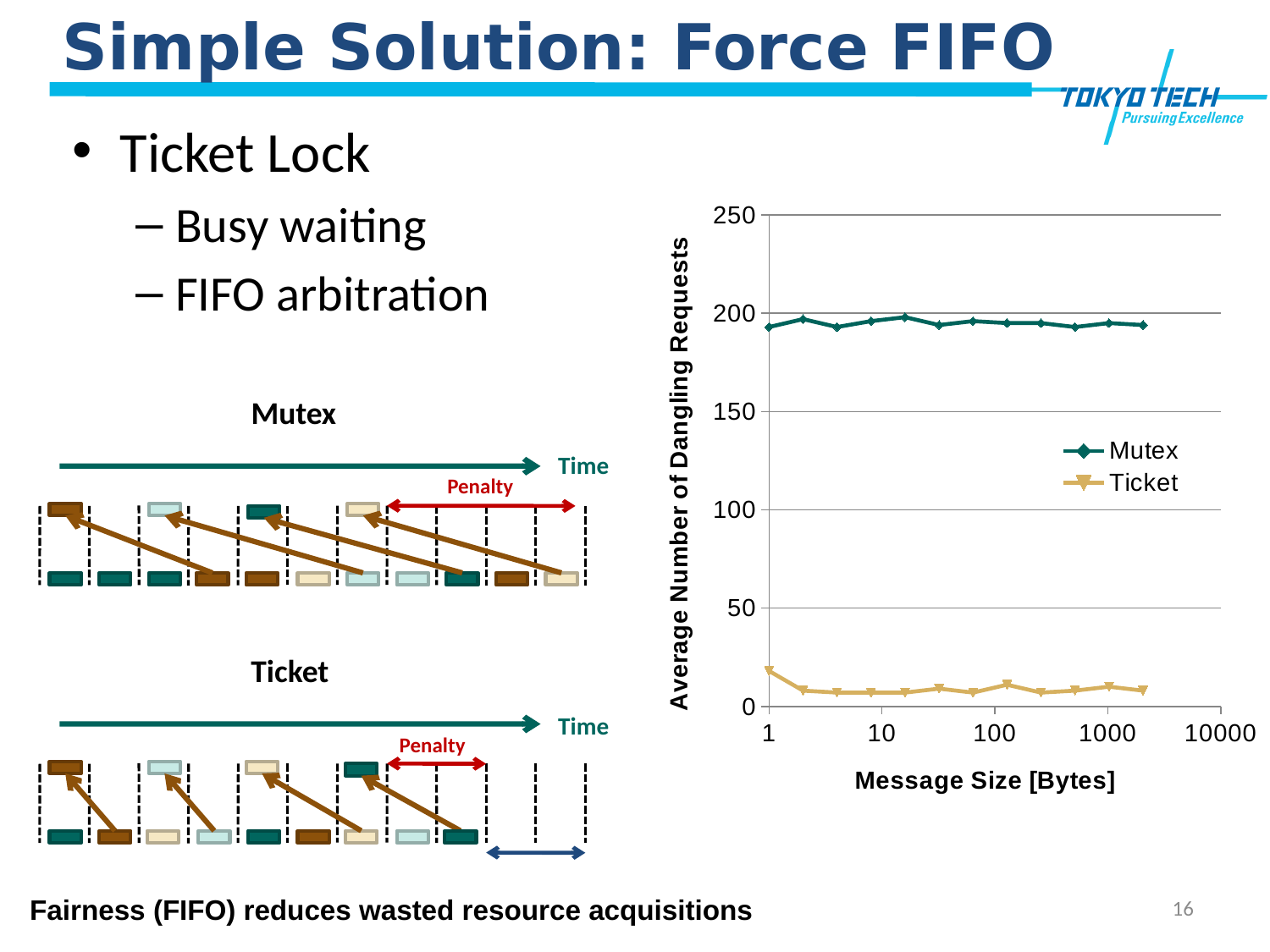
Does the Mutex series stay roughly flat, rise steadily, or fall steadily as message size increases? roughly flat What are the two series named in the chart legend? Mutex and Ticket Is the Ticket value at a message size of 1 byte greater or less than 50? less What kind of chart is shown on the slide? Line chart Is the Ticket value at a message size of 1000 bytes greater or less than 50? less Is the Mutex value at a message size of 1 byte greater or less than 150? greater Does the Ticket series rise or fall between message sizes of 1 and 2 bytes? fall How many series does the chart legend list? 2 Which series has the lower average number of dangling requests across all message sizes? Ticket Which series has the higher average number of dangling requests at a message size of 1000 bytes, Mutex or Ticket? Mutex What is the title of the chart's x axis? Message Size [Bytes]